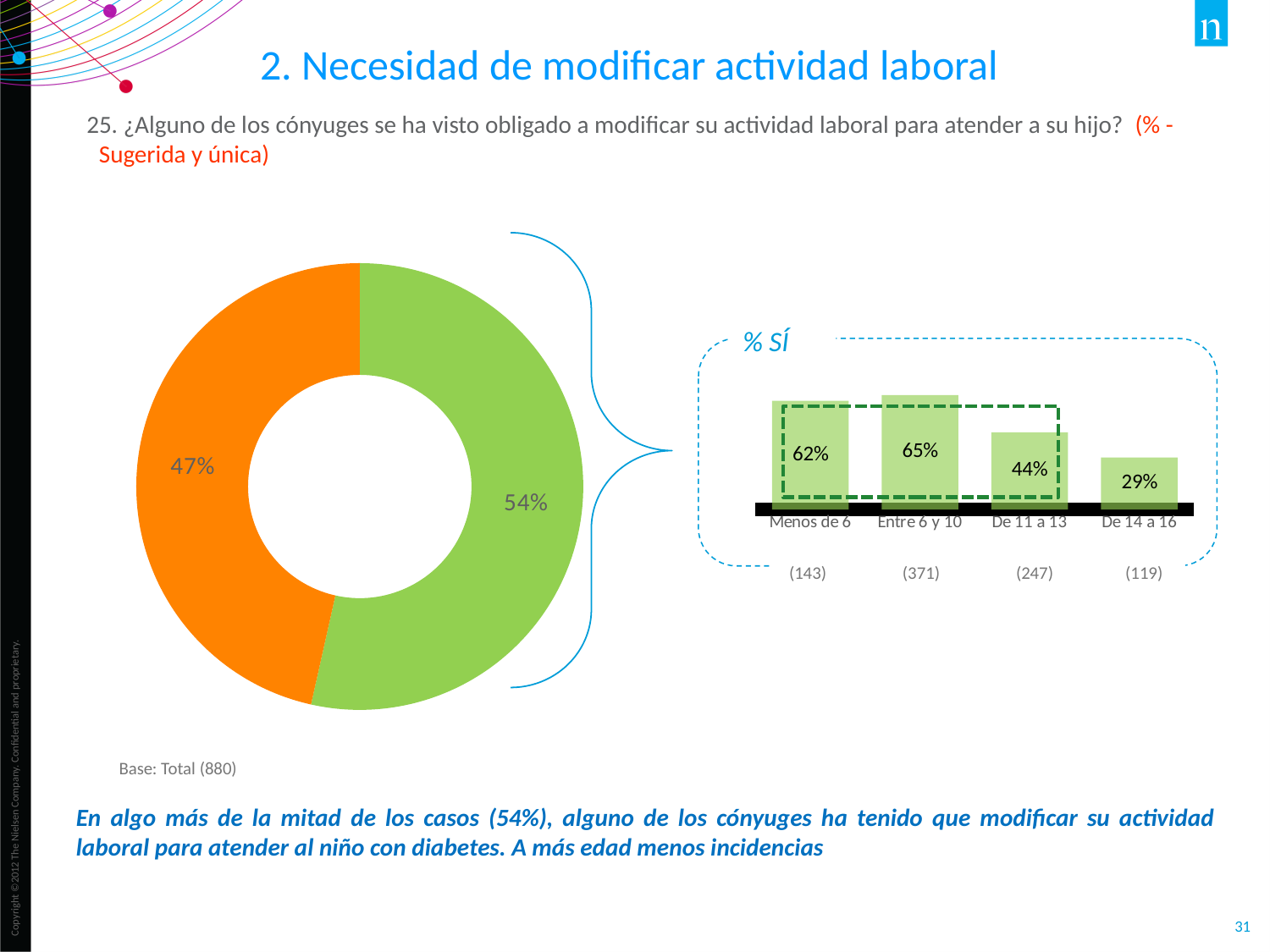
On the '% SÍ' bar chart, do the values rise or fall from 'Entre 6 y 10' to 'De 14 a 16'? fall On the '% SÍ' bar chart, which category has the lowest value? De 14 a 16 On the '% SÍ' bar chart, which category has the highest value? Entre 6 y 10 On the donut chart on the left, what value is shown for the green slice? 54% On the '% SÍ' bar chart, what is the difference between the values for 'Menos de 6' and 'De 11 a 13'? 18 percentage points On the '% SÍ' bar chart, what is the value for 'De 14 a 16'? 29% What kind of chart is the '% SÍ' chart on the right of the slide? bar chart On the '% SÍ' bar chart, what is the value for 'Entre 6 y 10'? 65% What kind of chart is the chart on the left of the slide? donut (pie) chart On the '% SÍ' bar chart, how many categories are shown? 4 On the donut chart on the left, which slice is larger, the green one or the orange one? the green one On the donut chart on the left, what value is shown for the orange slice? 47%